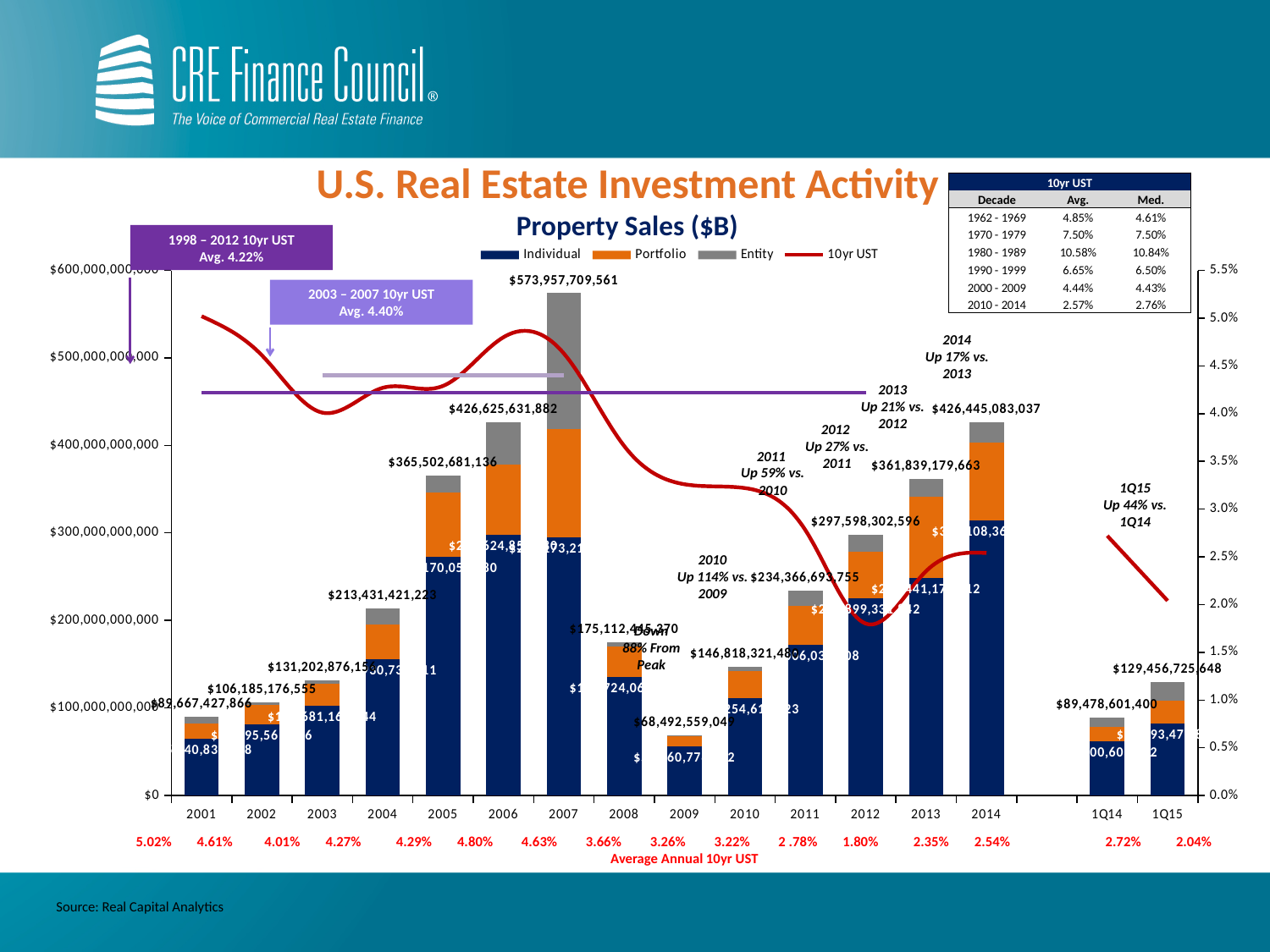
What is the difference between the total property sales labeled for 2014 and 2013? $64,605,903,374 Do total property sales rise or fall from 2009 to 2014? rise What is the total property sales value labeled for 2014? $426,445,083,037 Which year has the highest total property sales? 2007 Which year has the lowest total property sales bar? 2009 What is the total property sales value labeled for 2007? $573,957,709,561 Which has larger total property sales, 2005 or 2012? 2005 What is the Average Annual 10yr UST shown for 2012? 1.80% Which series in the legend is drawn as a red line? 10yr UST What kind of chart is used to show property sales? bar chart Is the total property sales value for 2004 greater or less than $200,000,000,000? greater How many series does the chart legend list? 4